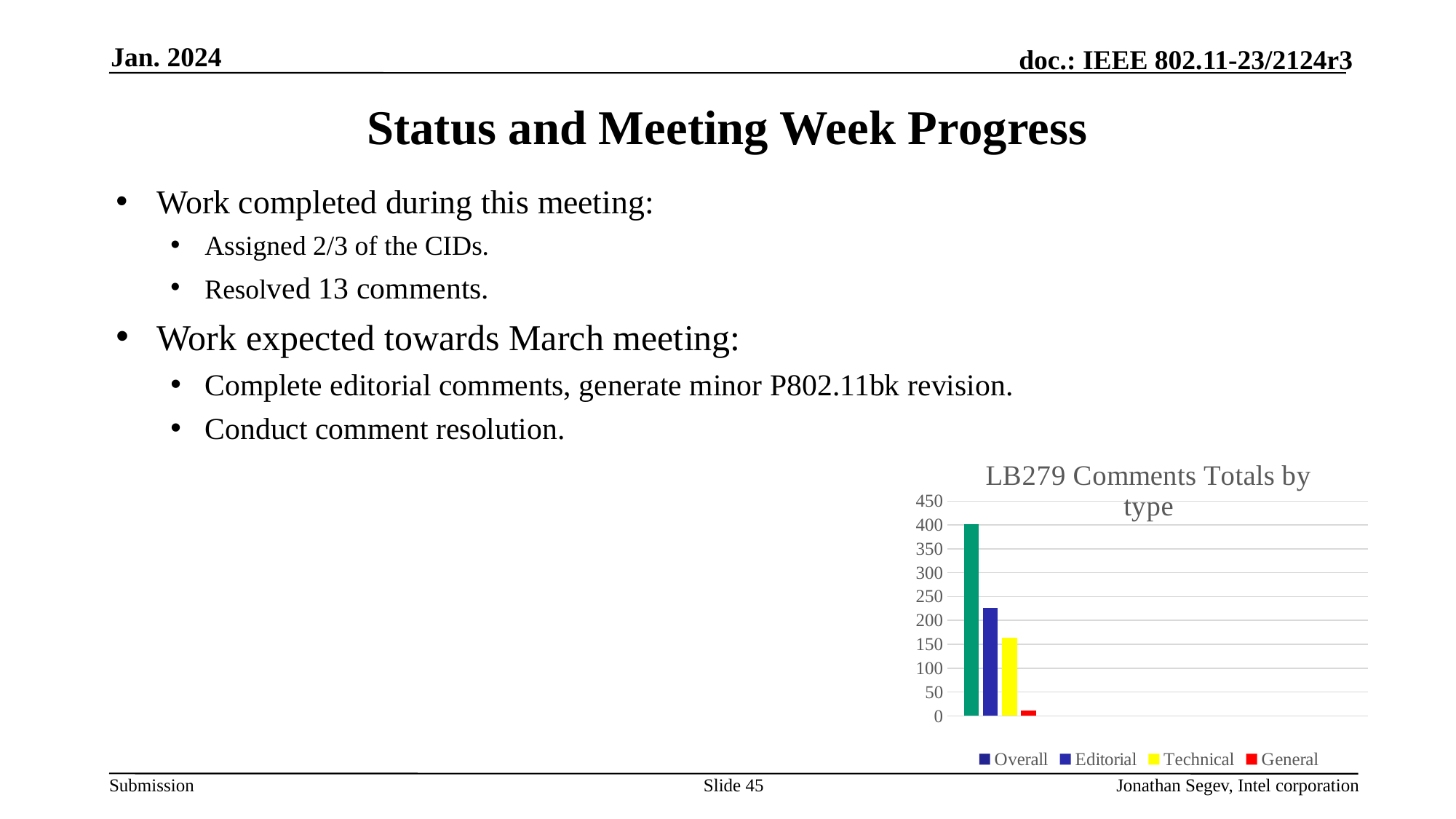
Is the value for Technical greater or less than 200? less Is the value for General greater or less than 50? less What type of chart is shown on the slide? bar chart Which series has the lowest value in the chart? General Is the value for Overall greater or less than 350? greater How many series does the chart legend list? 4 Which is larger, the value for Technical or the value for General? Technical What is the title of the chart on the slide? LB279 Comments Totals by type Which series has the highest value in the chart? Overall Which is larger, the value for Editorial or the value for Technical? Editorial What is the highest value shown on the vertical axis of the chart? 450